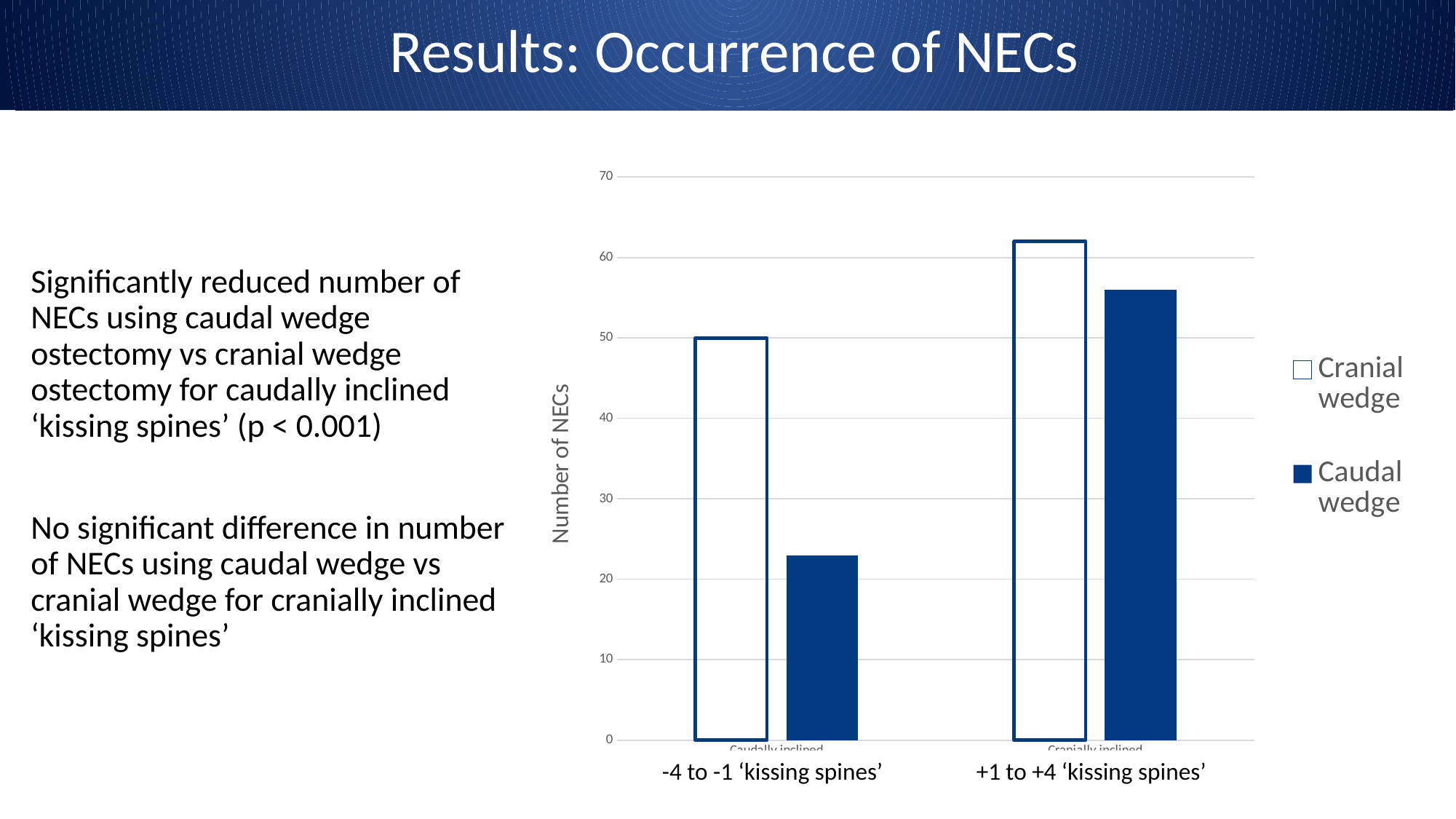
In the -4 to -1 'kissing spines' category, which series has the larger number of NECs? Cranial wedge Which bar in the chart is the tallest? Cranial wedge, +1 to +4 'kissing spines' Is the value for Caudal wedge in the -4 to -1 'kissing spines' category greater or less than 30? less What is the title of the chart's vertical axis? Number of NECs What is the number of NECs for Cranial wedge in the -4 to -1 'kissing spines' category? 50 How many categories are shown along the x axis of the chart? 2 In the +1 to +4 'kissing spines' category, which series has the larger number of NECs? Cranial wedge How many series does the chart's legend list? 2 Is the value for Cranial wedge in the +1 to +4 'kissing spines' category greater or less than 60? greater What kind of chart is shown on the slide? bar chart Is the value for Caudal wedge in the +1 to +4 'kissing spines' category greater or less than 50? greater Which bar in the chart is the shortest? Caudal wedge, -4 to -1 'kissing spines'